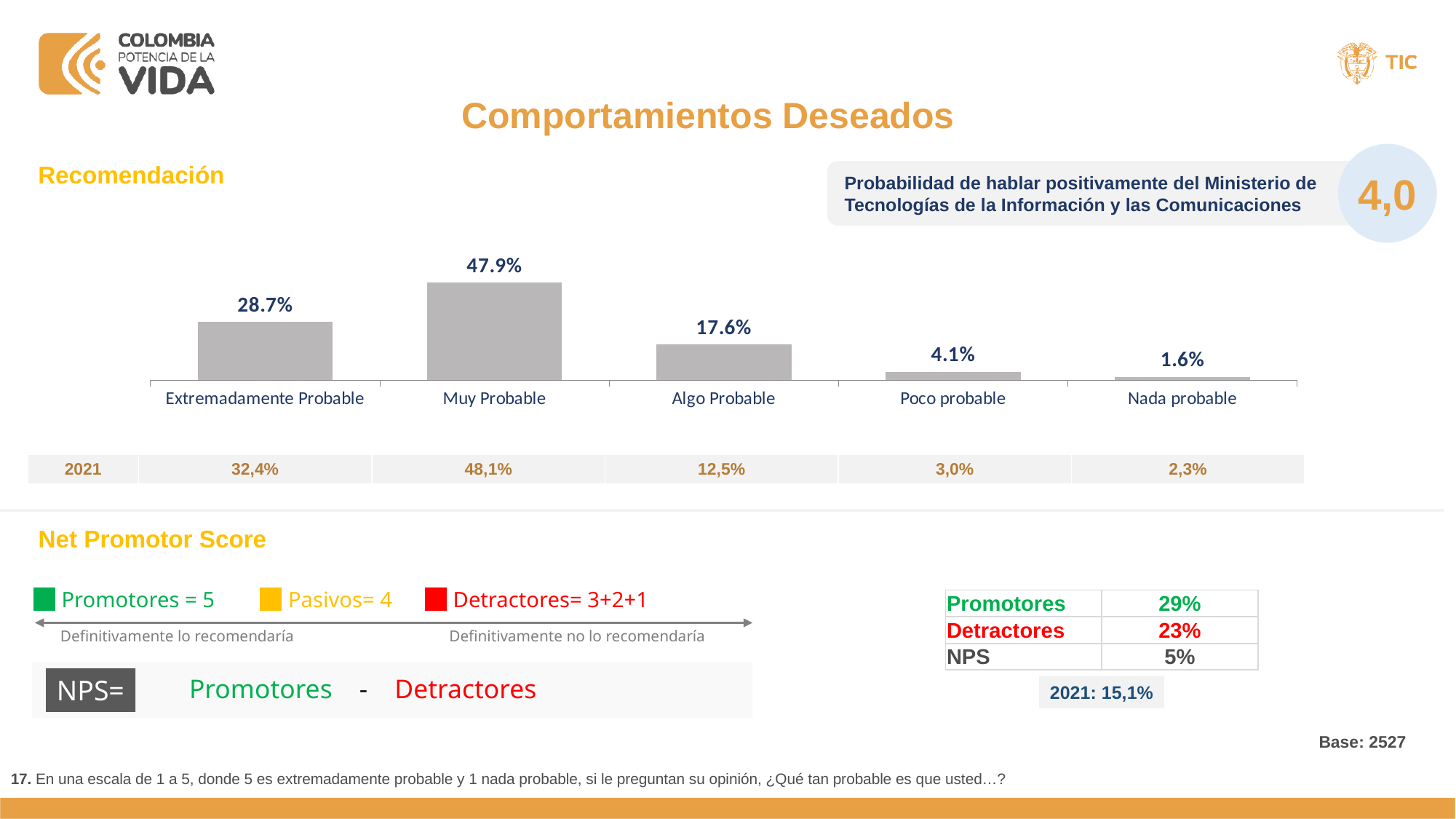
What is the 2021 value shown for Muy Probable in the row below the chart? 48,1% What is the value for Nada probable in the bar chart? 1.6% What is the value for Extremadamente Probable in the bar chart? 28.7% What is the value for Muy Probable in the bar chart? 47.9% Which category has the highest value in the bar chart? Muy Probable What kind of chart is shown under the Recomendación heading? bar chart Which is larger in the bar chart: Algo Probable or Poco probable? Algo Probable What is the value for Algo Probable in the bar chart? 17.6% Which category has the lowest value in the bar chart? Nada probable What is the difference between the values for Muy Probable and Extremadamente Probable? 19.2 percentage points How many categories does the bar chart show? 5 Do the values fall from Muy Probable to Nada probable along the x axis? Yes, they fall